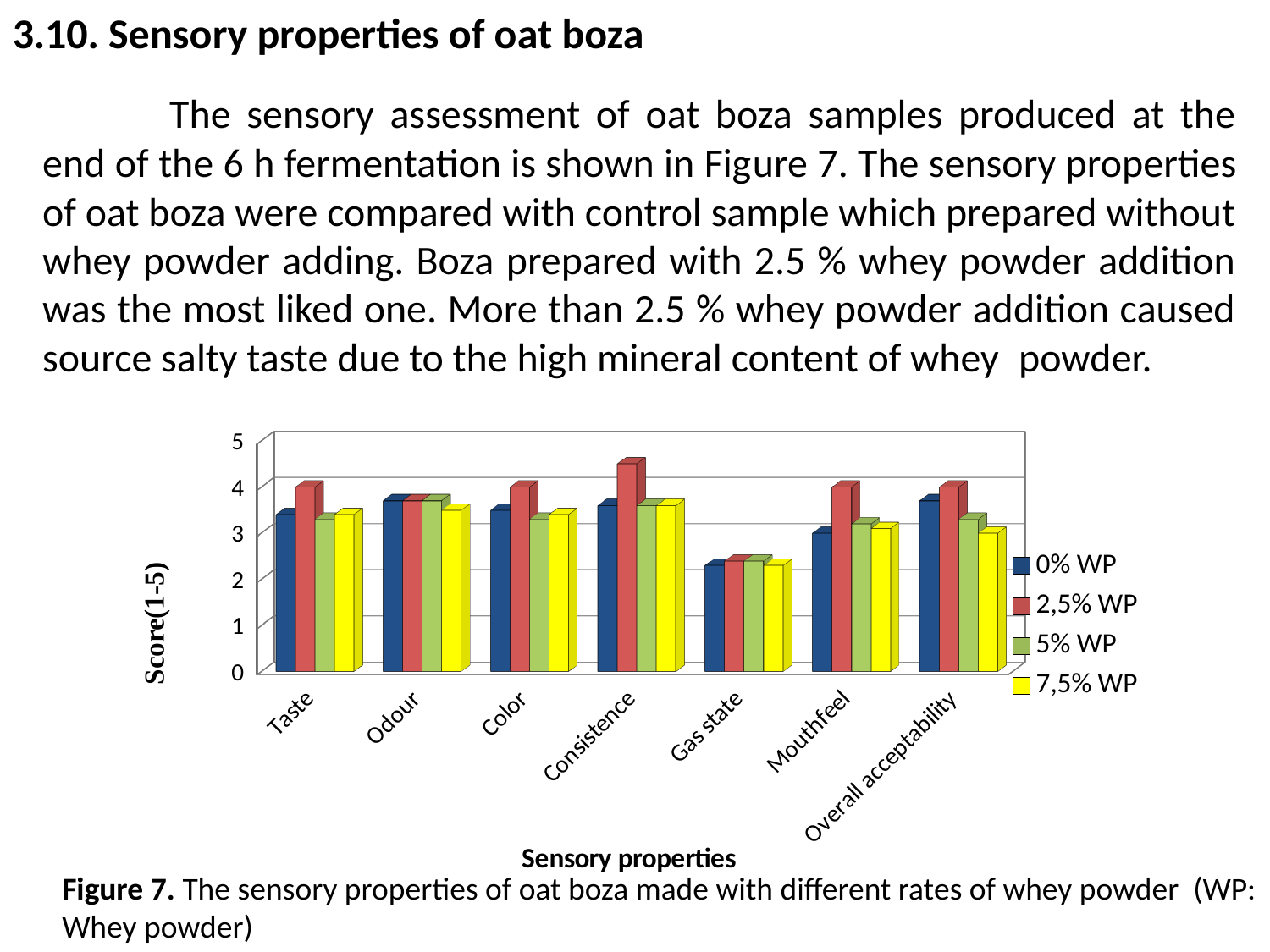
Is the 2,5% WP score for Consistence greater or less than 4? greater Is the 0% WP score for Gas state greater or less than 3? less Which sensory property has the lowest scores across all series? Gas state How many sensory properties are shown on the x axis of the chart? 7 How many series does the chart legend list? 4 What is the title of the vertical axis of the chart? Score(1-5) What is the title of the horizontal axis of the chart? Sensory properties For Consistence, which series has the larger score: 0% WP or 2,5% WP? 2,5% WP What kind of chart is shown in Figure 7? bar chart Which sensory property has the highest score for the 2,5% WP series? Consistence Is the 0% WP score for Odour greater or less than 3? greater For Mouthfeel, which series has the larger score: 2,5% WP or 7,5% WP? 2,5% WP